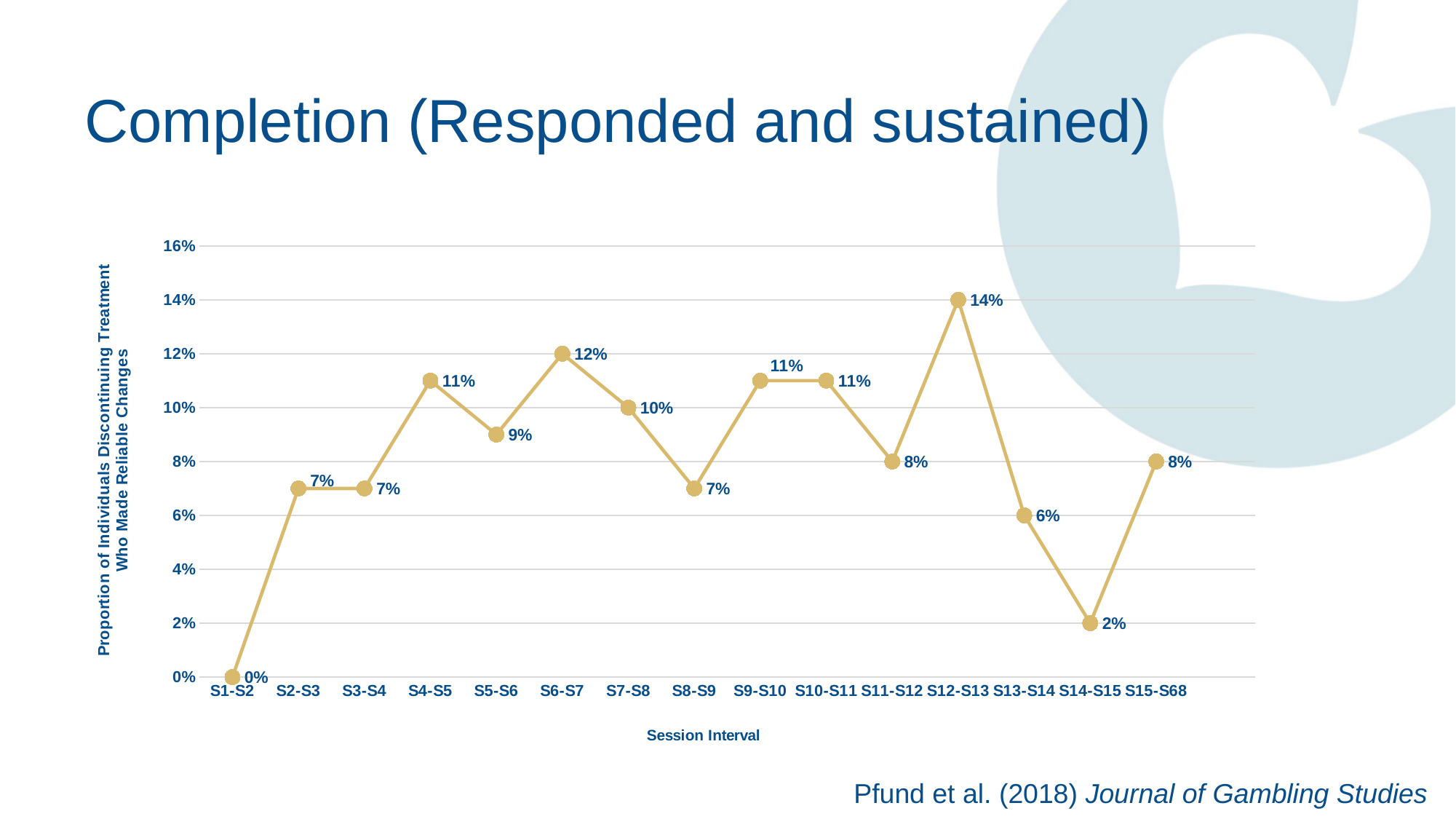
What is the label of the x axis? Session Interval How many session intervals are plotted on the x axis? 15 What is the value for the S15-S68 session interval? 8% Do the values rise or fall from S12-S13 to S14-S15? Fall What is the value for the S6-S7 session interval? 12% Which session interval has the lowest proportion? S1-S2 Which is larger, the value for S4-S5 or the value for S5-S6? S4-S5 What is the value for the S12-S13 session interval? 14% Which session interval has the highest proportion? S12-S13 What kind of chart is shown on the slide? Line chart What is the value for the S14-S15 session interval? 2% What is the difference between the values for S12-S13 and S14-S15? 12%